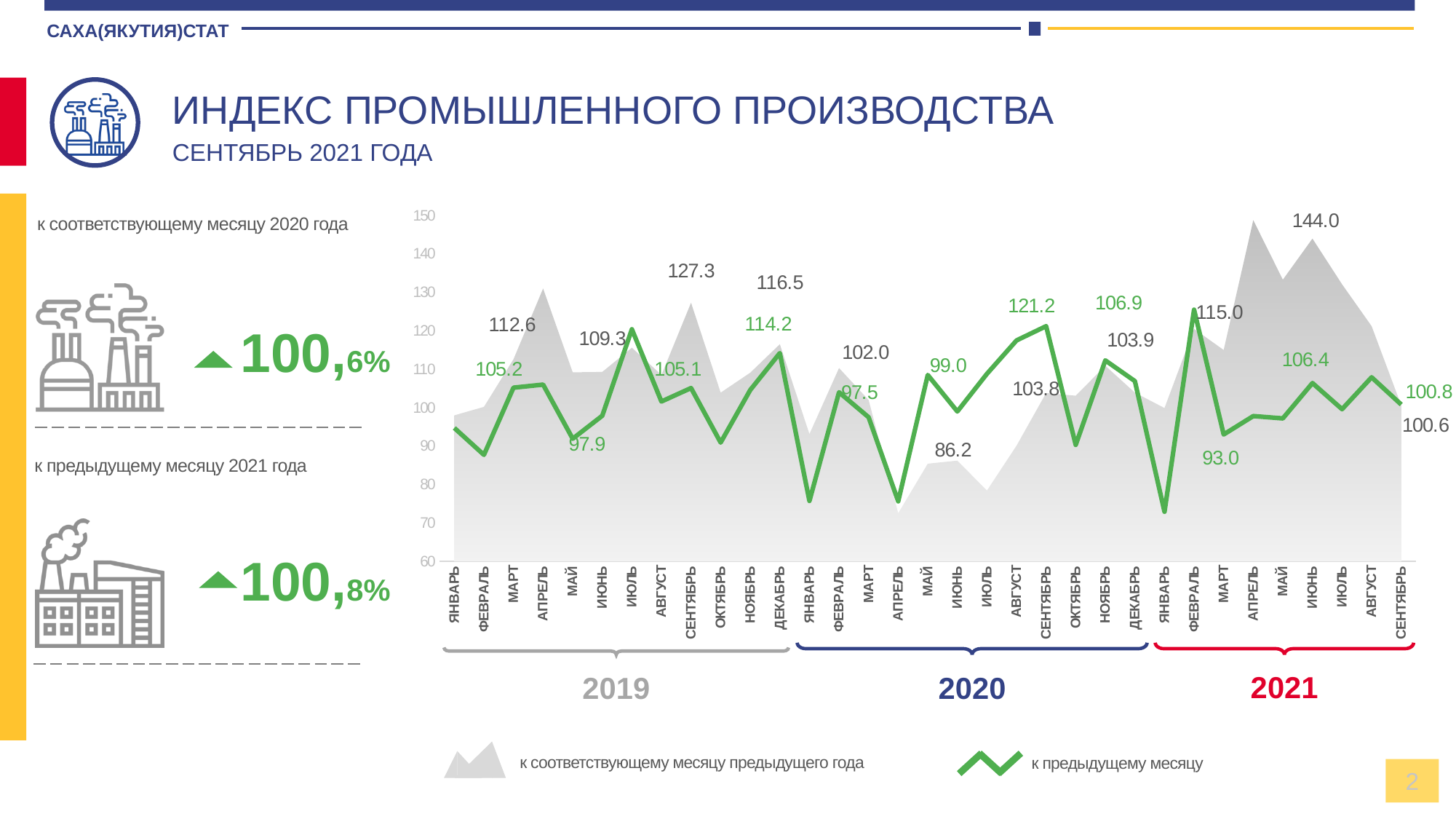
Does the grey area series rise or fall from June 2021 to September 2021? fall Is the green line value for January 2021 greater or less than 80? less What kind of chart is shown on the slide? combination area and line chart What is the difference between the September 2021 values of the green line (100.8) and the grey area (100.6)? 0.2 How many months are plotted along the x axis of the chart? 33 What is the value of the green line (к предыдущему месяцу) for September 2021? 100.8 Which years are marked by the brackets under the x axis of the chart? 2019, 2020, 2021 What is the value of the grey area series (к соответствующему месяцу предыдущего года) for September 2021? 100.6 How many series does the chart legend list? 2 What are the two legend entries of the chart? к соответствующему месяцу предыдущего года; к предыдущему месяцу Is the grey area value for April 2021 greater or less than 140? greater For September 2021, which is larger: the value relative to the previous month or the value relative to the same month of the previous year? relative to the previous month (100.8)